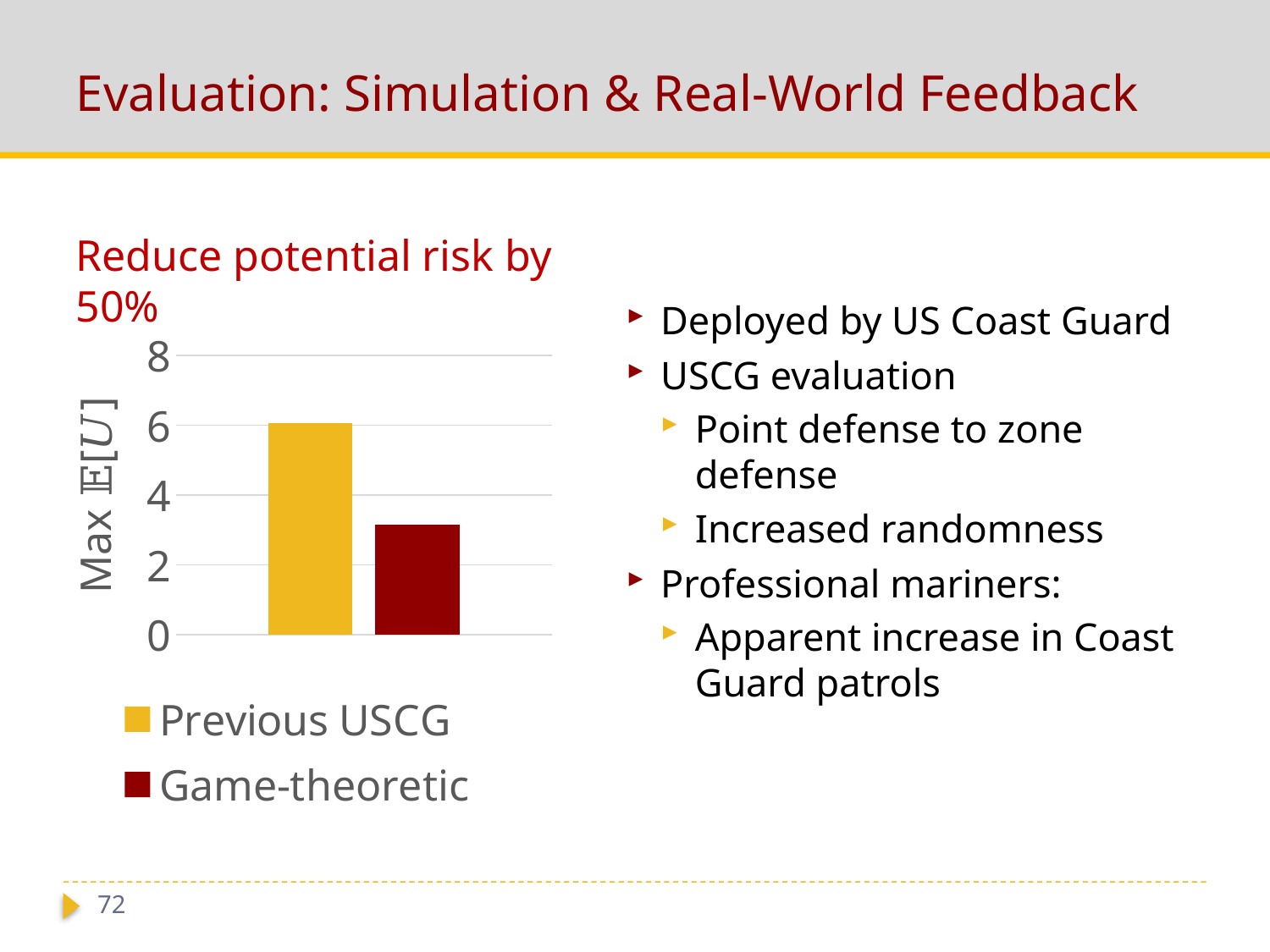
What is the title of the chart? Reduce potential risk by 50% Which series has the higher bar, Previous USCG or Game-theoretic? Previous USCG What colour is the bar for the Game-theoretic series? dark red Which series has the lowest value in the chart? Game-theoretic How many series does the chart legend list? 2 Is the value for Game-theoretic greater or less than 4? less Is the value for Previous USCG greater or less than 8? less Is the value for Game-theoretic greater or less than 2? greater Which series has the highest value in the chart? Previous USCG How many bars are plotted in the chart? 2 What kind of chart is shown on the slide? bar chart